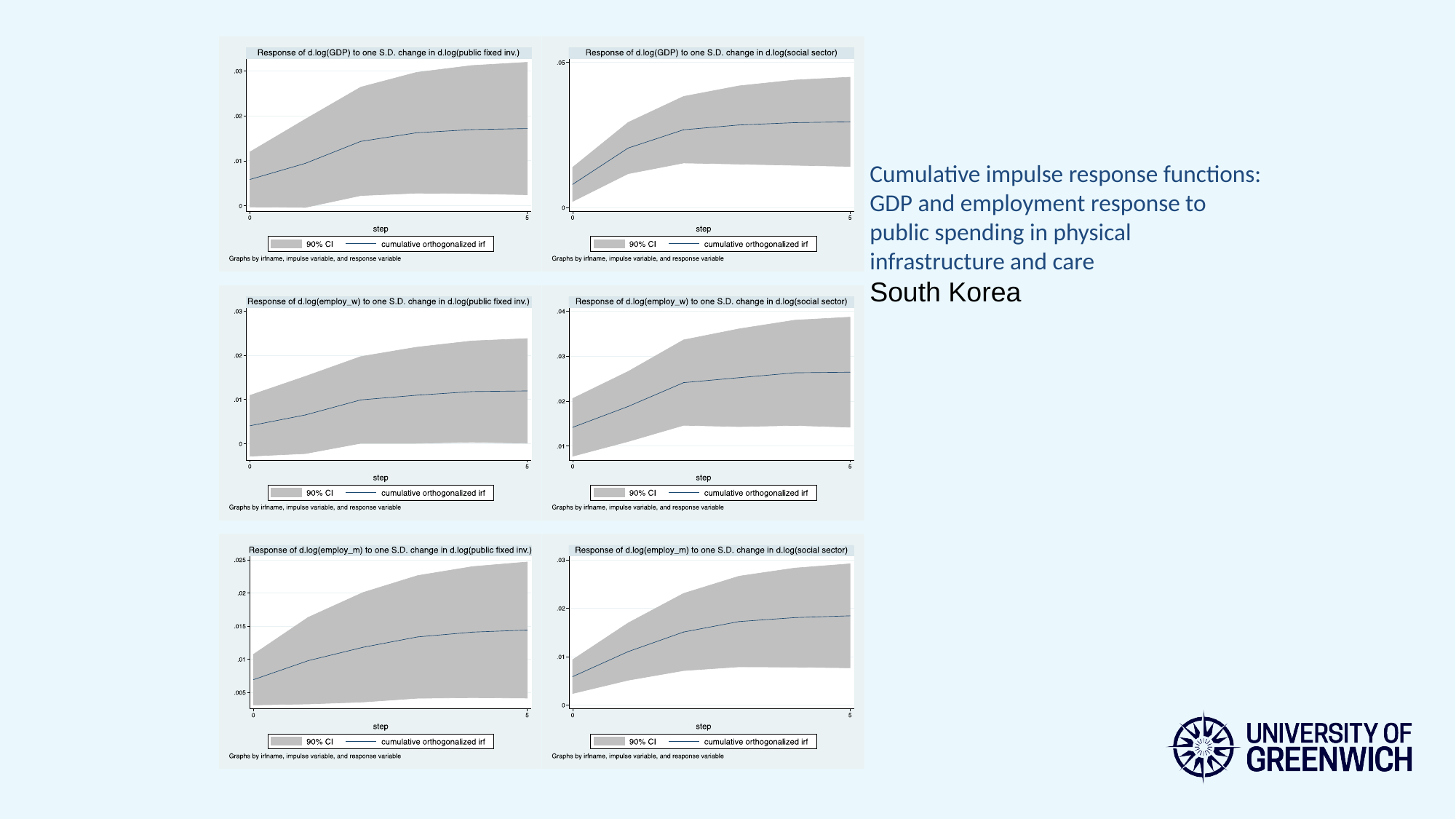
In the bottom-left chart (employ_m response to public fixed inv.), is the cumulative orthogonalized irf value at step 0 greater or less than .01? less In the top-right chart (GDP response to social sector), is the cumulative orthogonalized irf value at step 5 greater or less than .05? less In the top-left chart (GDP response to public fixed inv.), is the cumulative orthogonalized irf value at step 5 greater or less than .02? less In the top-left chart (GDP response to public fixed inv.), does the cumulative orthogonalized irf line rise or fall from step 0 to step 5? rise What kind of chart is the top-left chart, 'Response of d.log(GDP) to one S.D. change in d.log(public fixed inv.)'? line chart How many entries does the legend of the top-left chart list? 2 In the bottom-right chart (employ_m response to social sector), does the cumulative orthogonalized irf line rise or fall along the step axis? rise How many charts are shown on the slide? 6 In the top-left chart, what does the grey shaded area represent according to the legend? 90% CI